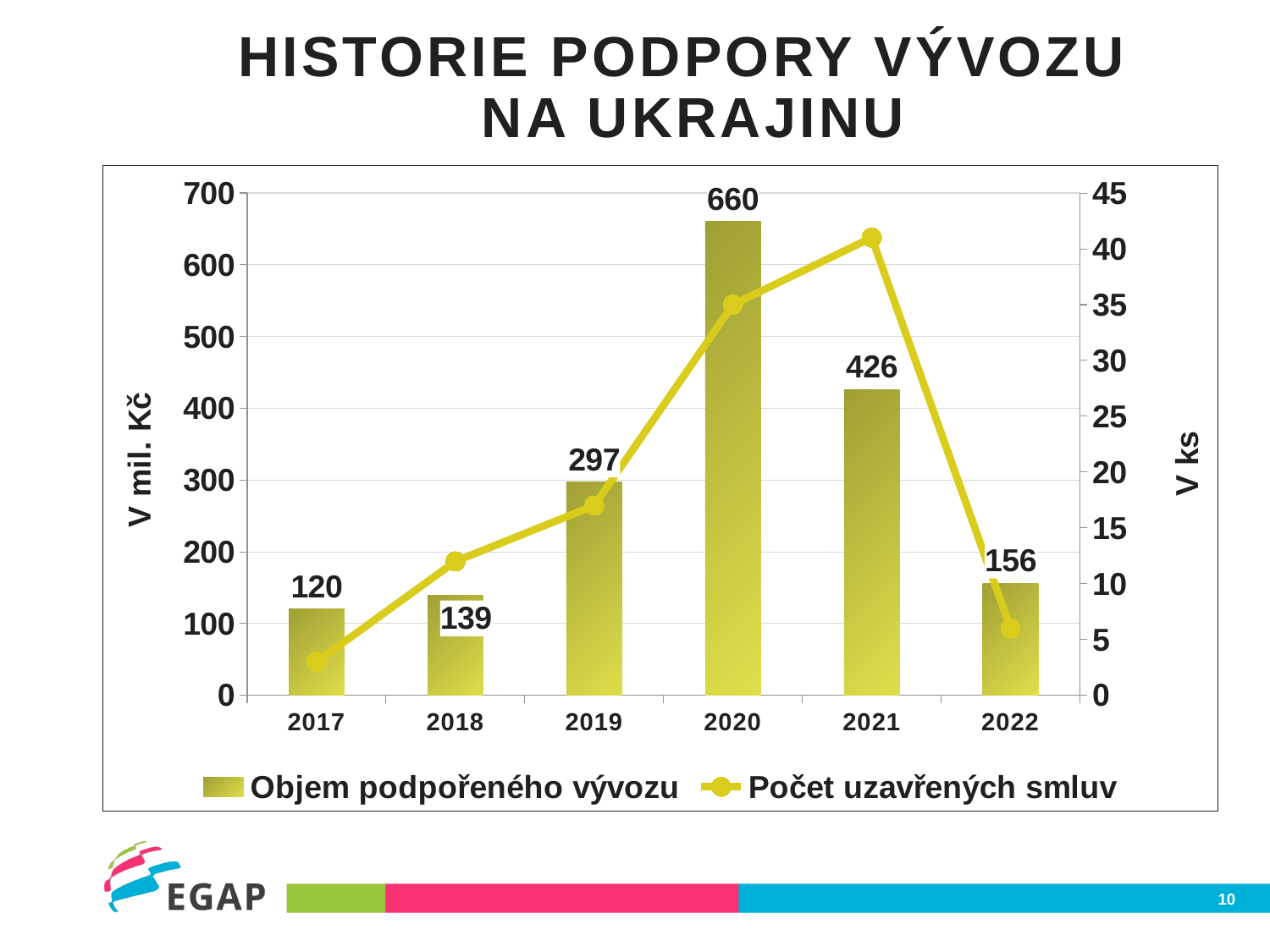
How many series does the legend list? 2 What is the difference between Objem podpořeného vývozu in 2020 and 2021? 234 What kind of chart is shown on the slide? Combined bar and line chart What is the value of Objem podpořeného vývozu for 2020? 660 Which is larger, Objem podpořeného vývozu in 2019 or in 2022? 2019 Which year has the lowest Objem podpořeného vývozu? 2017 How many years are shown on the x axis? 6 What is the value of Objem podpořeného vývozu for 2018? 139 Is the value of Počet uzavřených smluv for 2017 greater or less than 5? less Which year has the highest Objem podpořeného vývozu? 2020 Is the value of Počet uzavřených smluv for 2021 greater or less than 35? greater What is the label of the left vertical axis? V mil. Kč